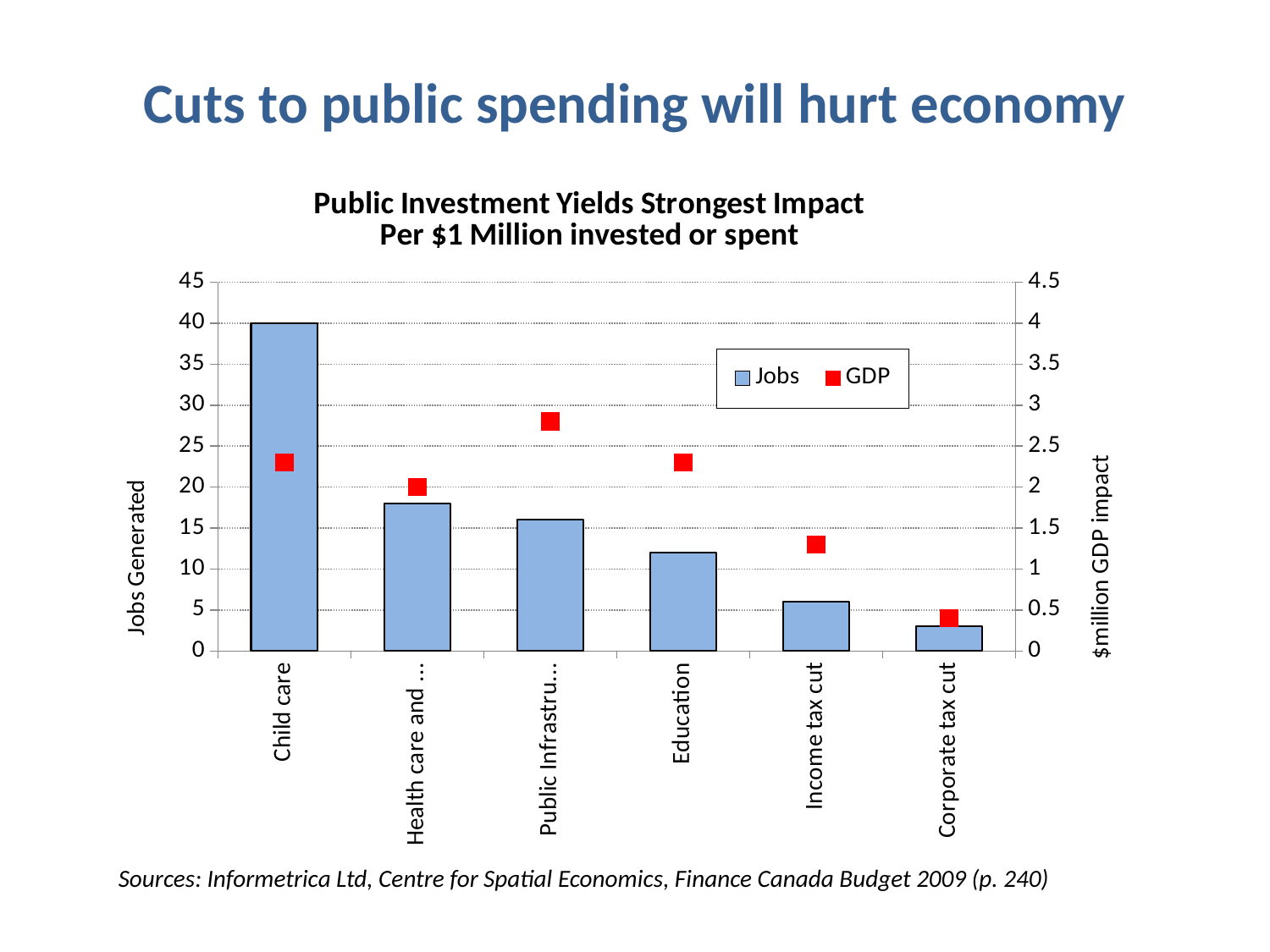
How many jobs are generated per $1 million for Child care? 40 Which category has the lowest GDP impact? Corporate tax cut Is the Jobs value for Education greater or less than 10? greater How many categories are shown on the x axis? 6 How many series does the legend list? 2 Is the GDP value for Income tax cut greater or less than 1.5? less Which category generates the fewest jobs? Corporate tax cut Do the Jobs values rise or fall from left to right across the categories? fall Which generates more jobs, Child care or Education? Child care Is the Jobs value for Income tax cut greater or less than 10? less Which category generates the most jobs? Child care